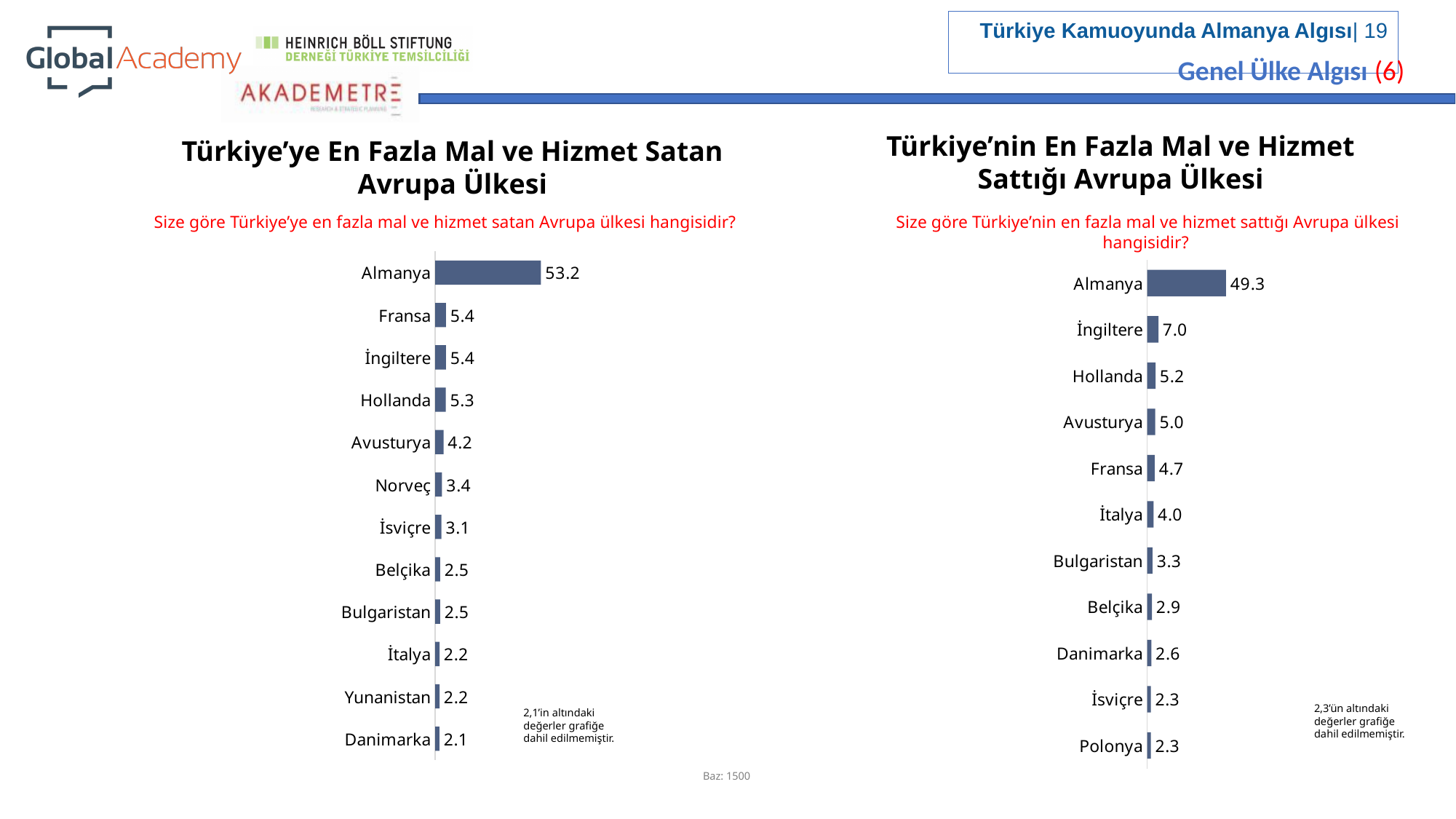
In the right chart (Türkiye'nin En Fazla Mal ve Hizmet Sattığı Avrupa Ülkesi), which country has the highest value? Almanya In the right chart (Türkiye'nin En Fazla Mal ve Hizmet Sattığı Avrupa Ülkesi), which is larger, the value for Fransa or the value for İtalya? Fransa In the right chart (Türkiye'nin En Fazla Mal ve Hizmet Sattığı Avrupa Ülkesi), what is the value for Polonya? 2.3 In the left chart (Türkiye'ye En Fazla Mal ve Hizmet Satan Avrupa Ülkesi), what is the value for Almanya? 53.2 What type of chart is the right chart (Türkiye'nin En Fazla Mal ve Hizmet Sattığı Avrupa Ülkesi)? Bar chart How many countries are shown in the left chart (Türkiye'ye En Fazla Mal ve Hizmet Satan Avrupa Ülkesi)? 12 In the right chart (Türkiye'nin En Fazla Mal ve Hizmet Sattığı Avrupa Ülkesi), what is the difference between the values for İngiltere and Hollanda? 1.8 In the left chart (Türkiye'ye En Fazla Mal ve Hizmet Satan Avrupa Ülkesi), what is the value for Norveç? 3.4 In the right chart (Türkiye'nin En Fazla Mal ve Hizmet Sattığı Avrupa Ülkesi), what is the value for İngiltere? 7.0 In the left chart (Türkiye'ye En Fazla Mal ve Hizmet Satan Avrupa Ülkesi), which country has the highest value? Almanya What is the difference between the value for Almanya in the left chart and the value for Almanya in the right chart? 3.9 In the left chart (Türkiye'ye En Fazla Mal ve Hizmet Satan Avrupa Ülkesi), which country has the lowest value? Danimarka